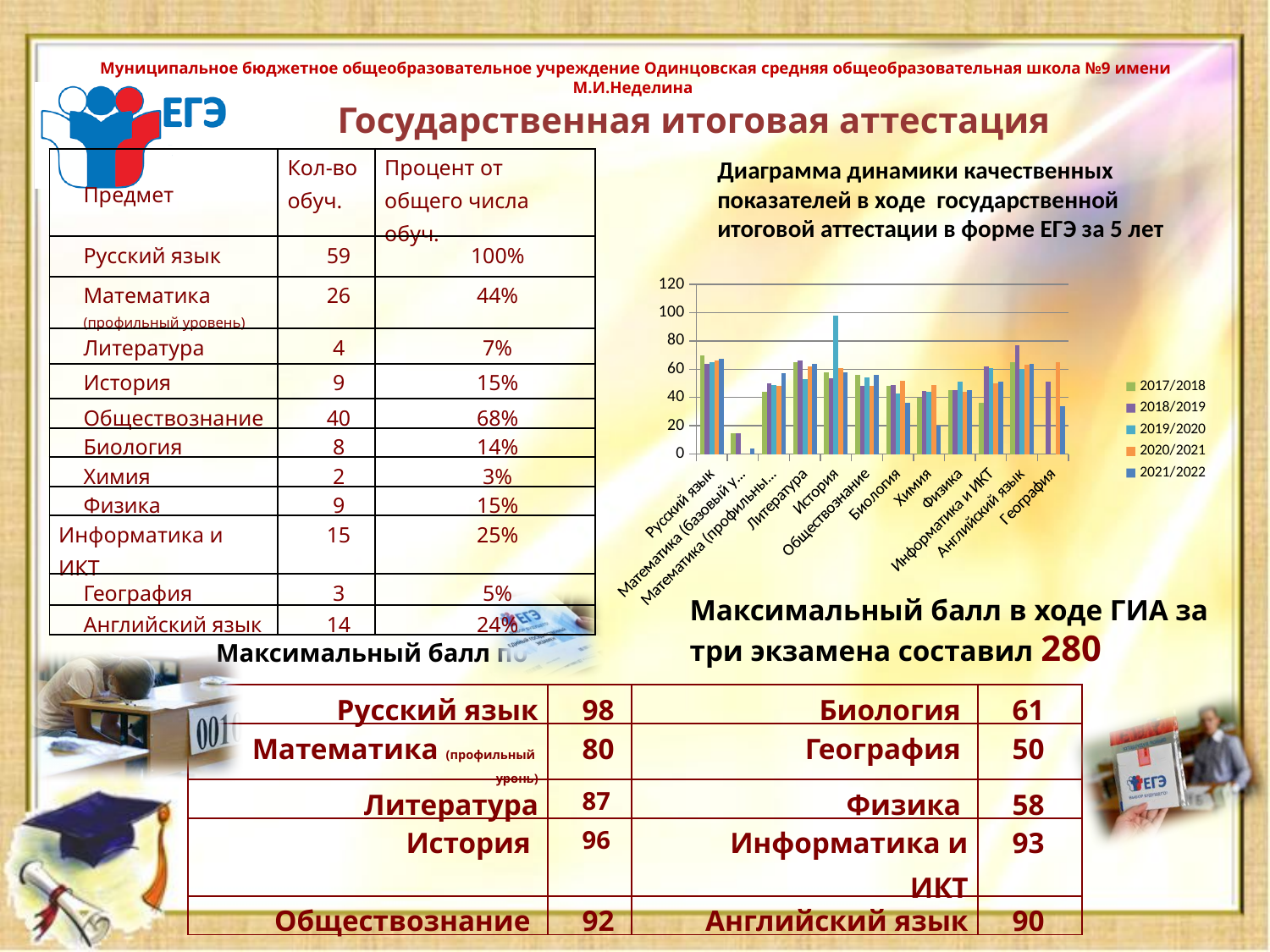
How many subject categories are shown along the x axis of the chart? 12 Is the 2021/2022 value for География greater or less than 40? less Is the 2018/2019 value for Математика (базовый уровень) greater or less than 40? less Is the 2018/2019 value for Английский язык greater or less than 60? greater What is the highest value shown on the chart's vertical axis? 120 Which school years are listed in the chart legend? 2017/2018, 2018/2019, 2019/2020, 2020/2021, 2021/2022 How many series does the chart legend list? 5 What kind of chart is shown on the slide? bar chart Which category has the tallest bar in the chart? История